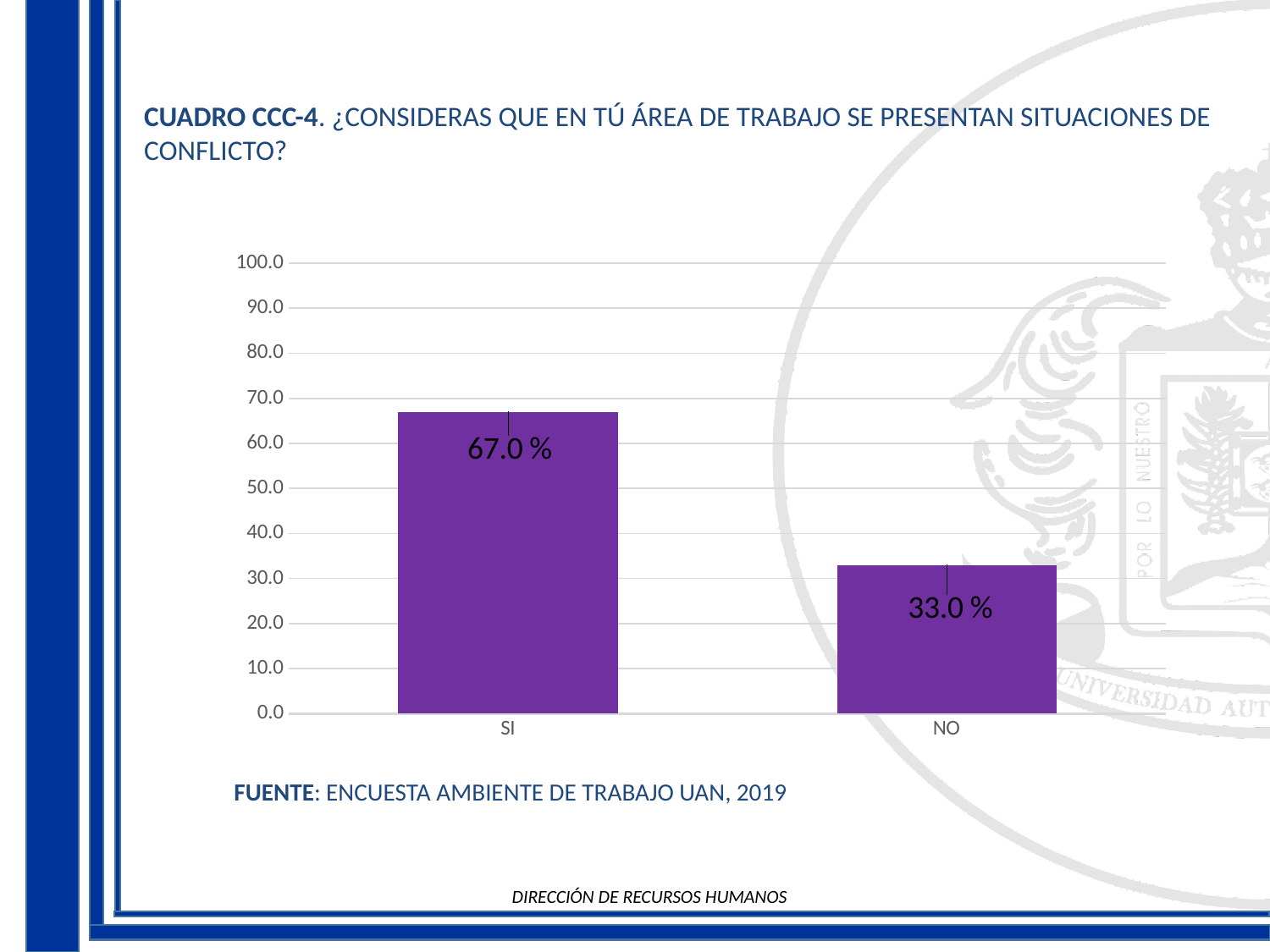
How many categories are shown on the x axis? 2 Is the value for NO greater or less than 40.0? less What is the value for SI? 67.0 % Is the value for SI greater or less than 60.0? greater What is the difference between the values for SI and NO? 34.0 % What kind of chart is shown on the slide? bar chart Which is larger, the value for SI or the value for NO? SI Which category has the lowest value? NO What is the value for NO? 33.0 % What colour are the bars in the chart? purple What is the maximum value shown on the y axis? 100.0 Which category has the highest value? SI